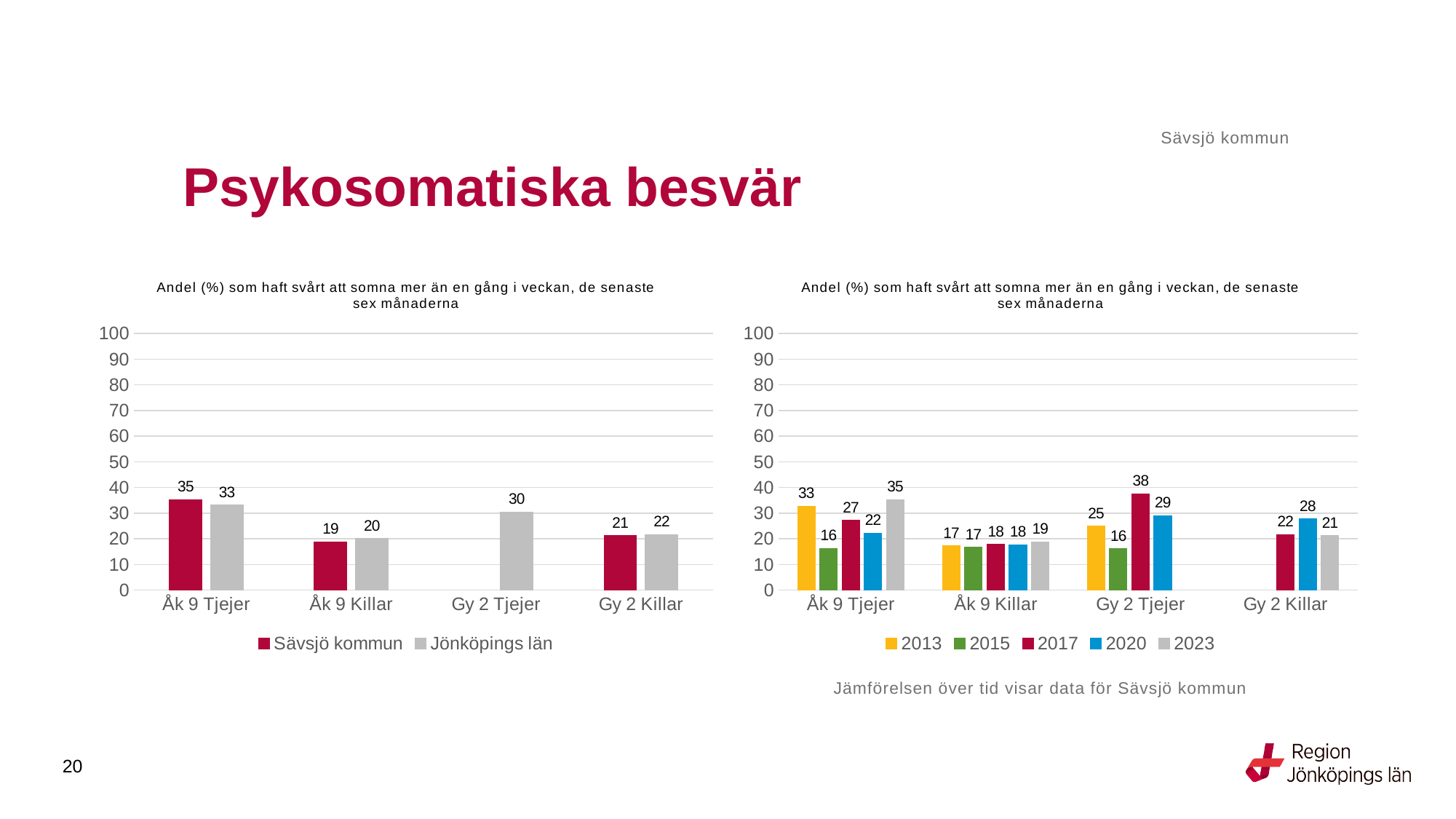
In the right chart, what is the difference between the 2017 and 2015 values for Gy 2 Tjejer? 22 In the right chart, what is the value for 2023 for Åk 9 Tjejer? 35 In the left chart, what is the value for Sävsjö kommun for Åk 9 Tjejer? 35 In the right chart, which year has the highest value for Gy 2 Killar? 2020 In the right chart, which is larger for Åk 9 Tjejer: the value for 2013 or the value for 2015? 2013 In the right chart, how many series does the legend list? 5 In the left chart, how many series does the legend list? 2 In the left chart, which category has the lowest value for Sävsjö kommun? Åk 9 Killar In the right chart, what is the value for 2017 for Gy 2 Tjejer? 38 In the left chart, what is the value for Jönköpings län for Gy 2 Tjejer? 30 What type of chart is the left chart? Bar chart In the left chart, what is the difference between Sävsjö kommun and Jönköpings län for Åk 9 Tjejer? 2